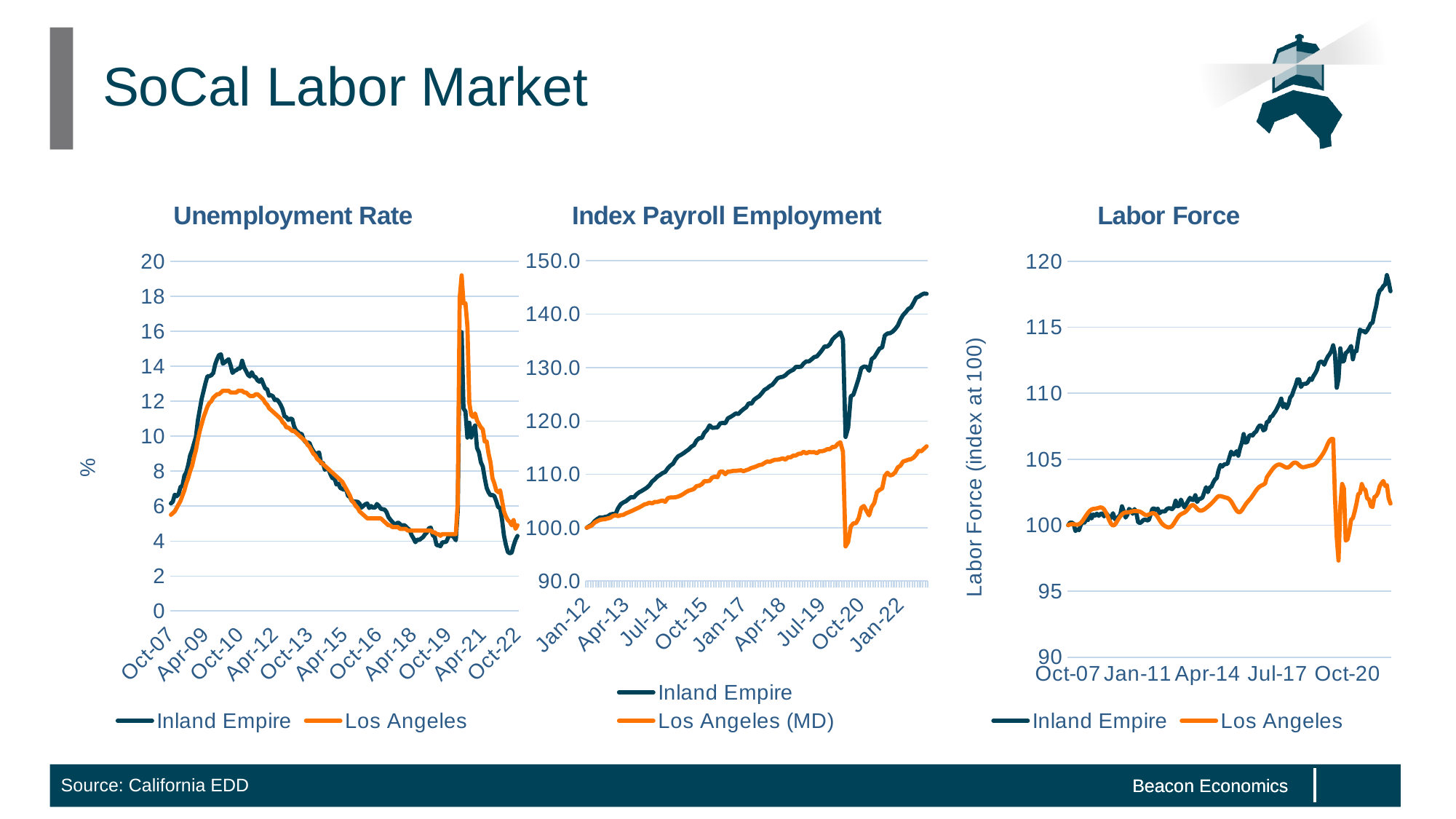
On the Index Payroll Employment chart, is the final value for Inland Empire greater or less than 140.0? greater On the Unemployment Rate chart, is the peak value for Los Angeles around 2020 greater or less than 18? greater On the Labor Force chart, is the final value for Los Angeles greater or less than 105? less On the Unemployment Rate chart, does the Inland Empire series rise or fall from Oct-10 to Apr-18? fall What kind of chart is the Unemployment Rate chart? line chart On the Index Payroll Employment chart, which series is higher at the end of the period, Inland Empire or Los Angeles (MD)? Inland Empire What is the y-axis title of the Labor Force chart? Labor Force (index at 100) On the Index Payroll Employment chart, does the Inland Empire series rise or fall from Jan-12 to the start of 2020? rise How many series does the legend of the Index Payroll Employment chart list? 2 On the Unemployment Rate chart, which series is higher around Oct-10, Inland Empire or Los Angeles? Inland Empire What are the two legend entries on the Index Payroll Employment chart? Inland Empire and Los Angeles (MD)